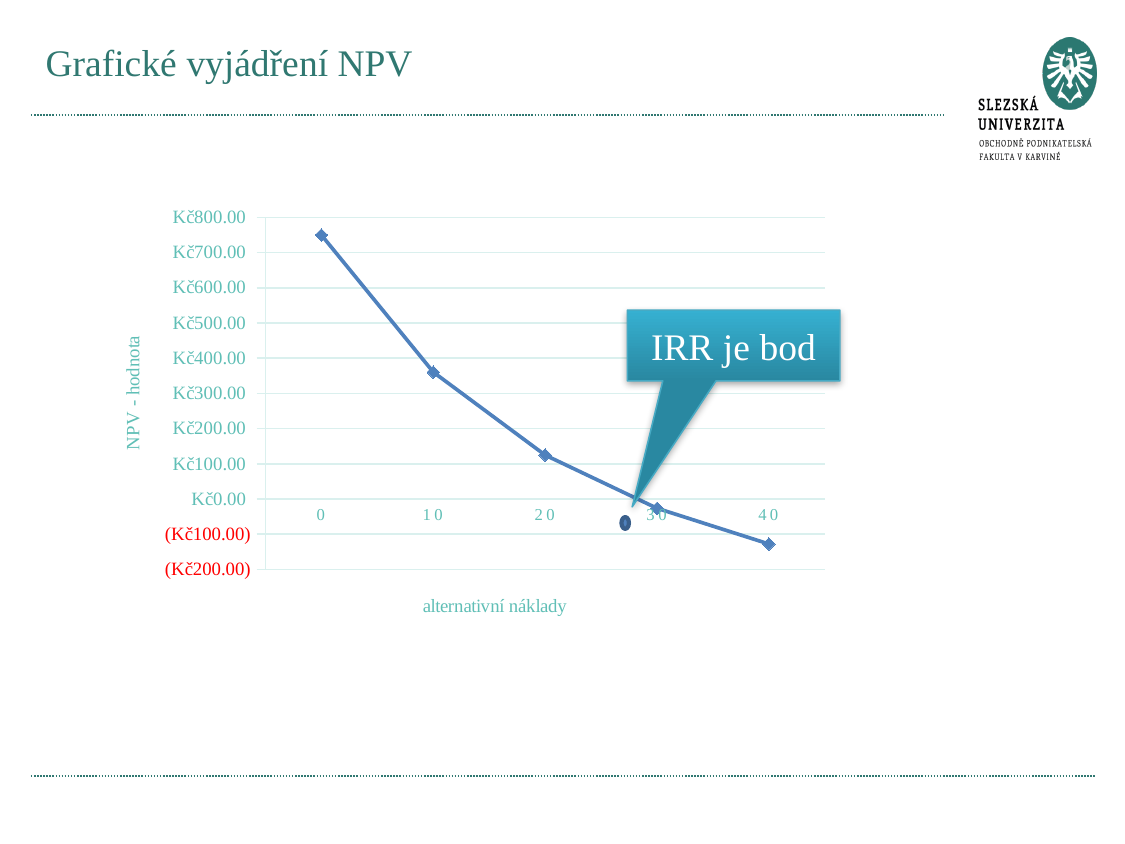
Is the NPV value at alternativní náklady 10 greater or less than Kč300.00? greater Is the NPV value at alternativní náklady 40 greater or less than Kč0.00? less How many data points are plotted on the line? 5 Which has the larger NPV value: alternativní náklady 10 or 20? 10 What is the title of the vertical axis of the chart? NPV - hodnota Is the NPV value at alternativní náklady 10 greater or less than Kč400.00? less At which alternativní náklady value is the NPV highest? 0 At which alternativní náklady value is the NPV lowest? 40 What kind of chart is shown on the slide? line chart Do the NPV values rise or fall as the alternativní náklady increase along the x axis? fall